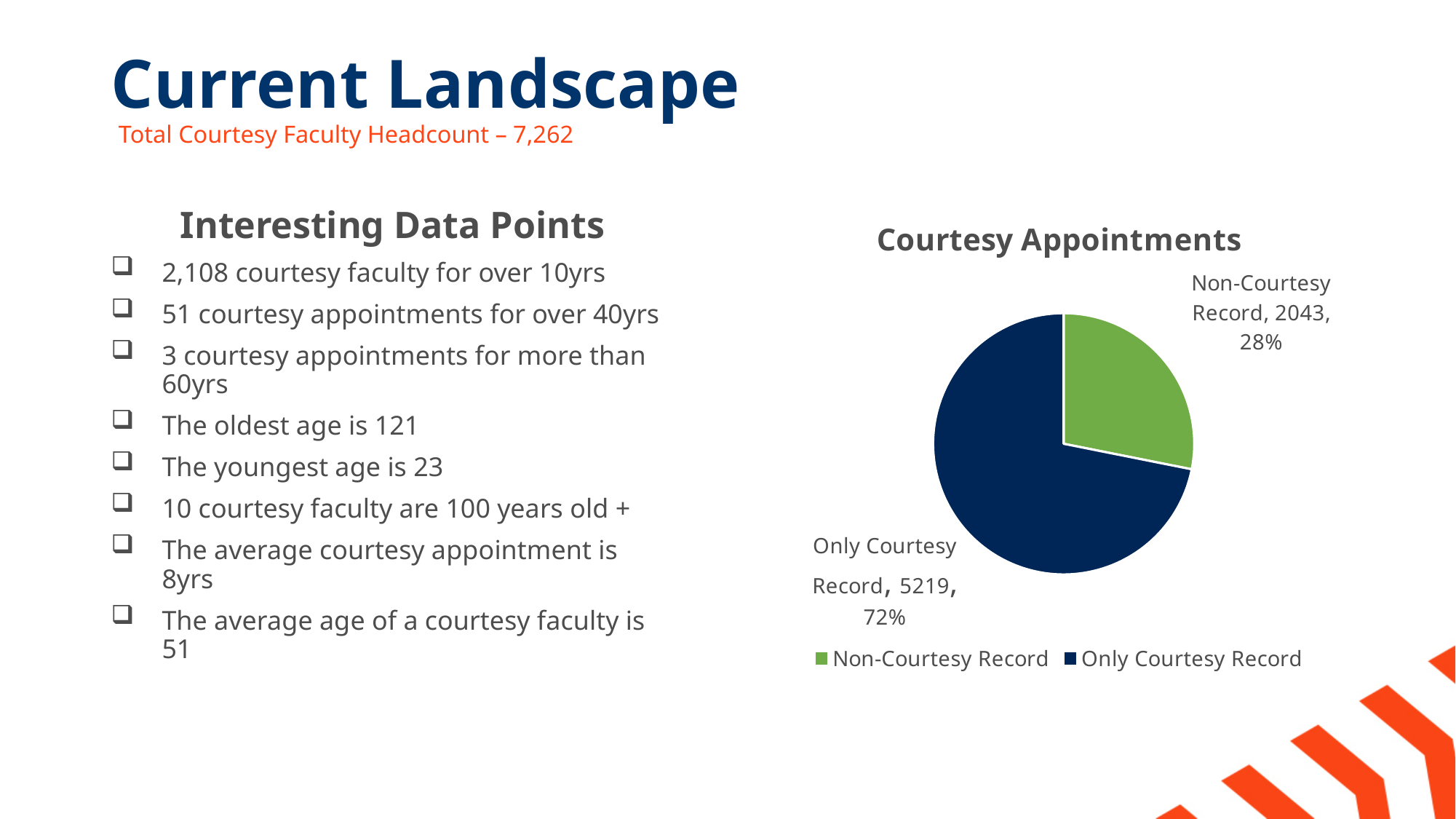
Which category has the smallest slice? Non-Courtesy Record What is the value for Non-Courtesy Record? 2043 Which colour represents Non-Courtesy Record in the chart? green What share of the pie does Non-Courtesy Record represent? 28% What kind of chart is shown on the slide? pie chart How many slices does the pie chart have? 2 Which is larger, Non-Courtesy Record or Only Courtesy Record? Only Courtesy Record Which category has the largest slice? Only Courtesy Record What share of the pie does Only Courtesy Record represent? 72% What is the difference between the Only Courtesy Record and Non-Courtesy Record values? 3176 What is the value for Only Courtesy Record? 5219 What is the title of the chart? Courtesy Appointments